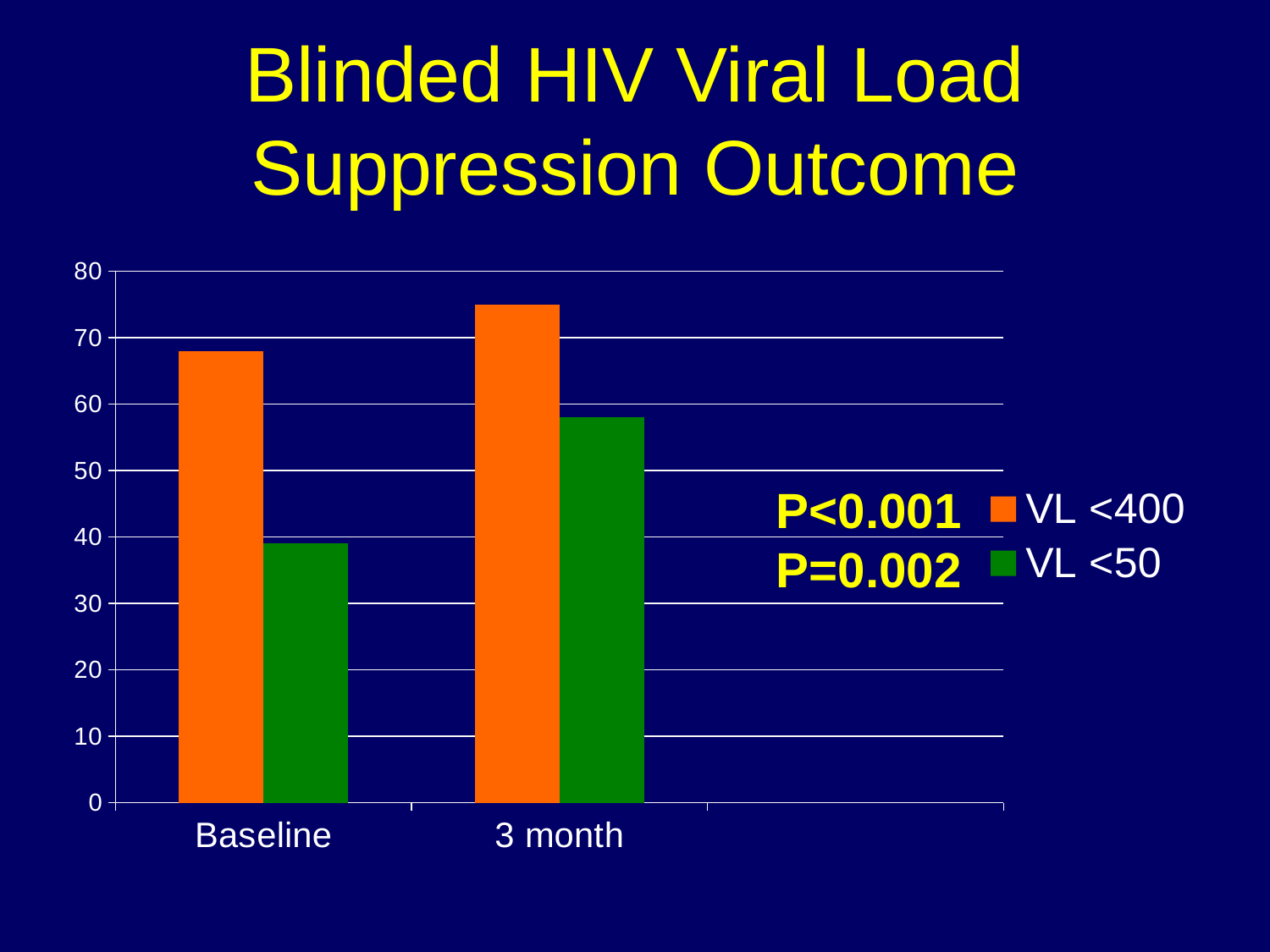
How many series does the legend list? 2 Which is larger, VL <50 at Baseline or VL <50 at 3 month? VL <50 at 3 month Is the value for VL <50 at Baseline greater or less than 50? less Which category has the lowest VL <50 value? Baseline What kind of chart is shown on the slide? bar chart Is the value for VL <400 at Baseline greater or less than 60? greater Is the value for VL <50 at 3 month greater or less than 50? greater How many categories are shown on the x axis? 2 What is the title of the chart? Blinded HIV Viral Load Suppression Outcome Do the VL <400 values rise or fall from Baseline to 3 month? rise Which category has the highest VL <400 value? 3 month